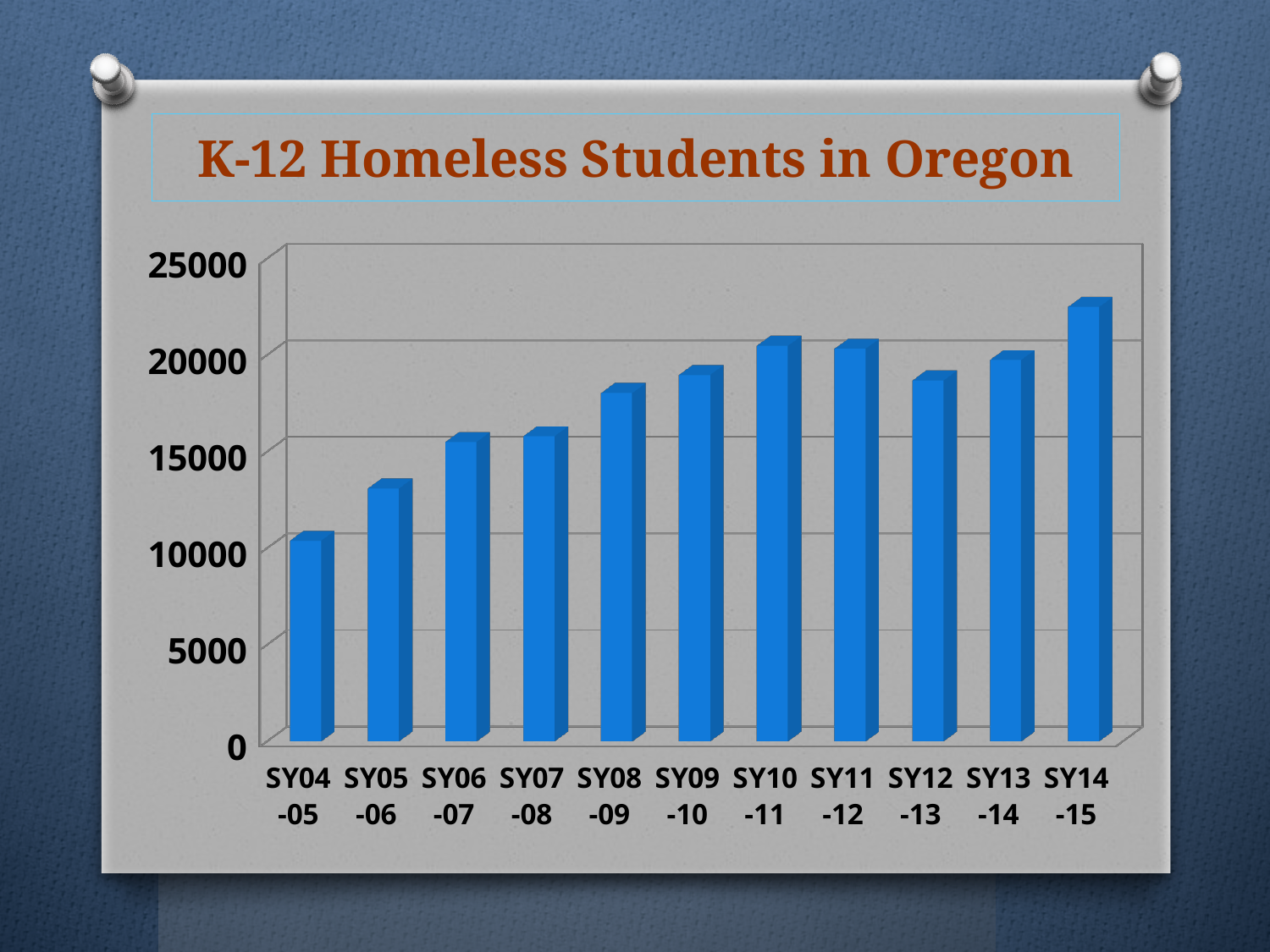
Which is larger, the value for SY12-13 or the value for SY14-15? SY14-15 Is the value for SY04-05 greater or less than 15000? less Which school year has the lowest number of homeless students? SY04-05 Is the value for SY14-15 greater or less than 20000? greater Which school year has the highest number of homeless students? SY14-15 Is the value for SY08-09 greater or less than 15000? greater Which is larger, the value for SY05-06 or the value for SY08-09? SY08-09 How many school years are plotted on the chart? 11 What is the title of the chart? K-12 Homeless Students in Oregon Do the values generally rise or fall from SY04-05 to SY14-15? rise What kind of chart is shown on the slide? bar chart